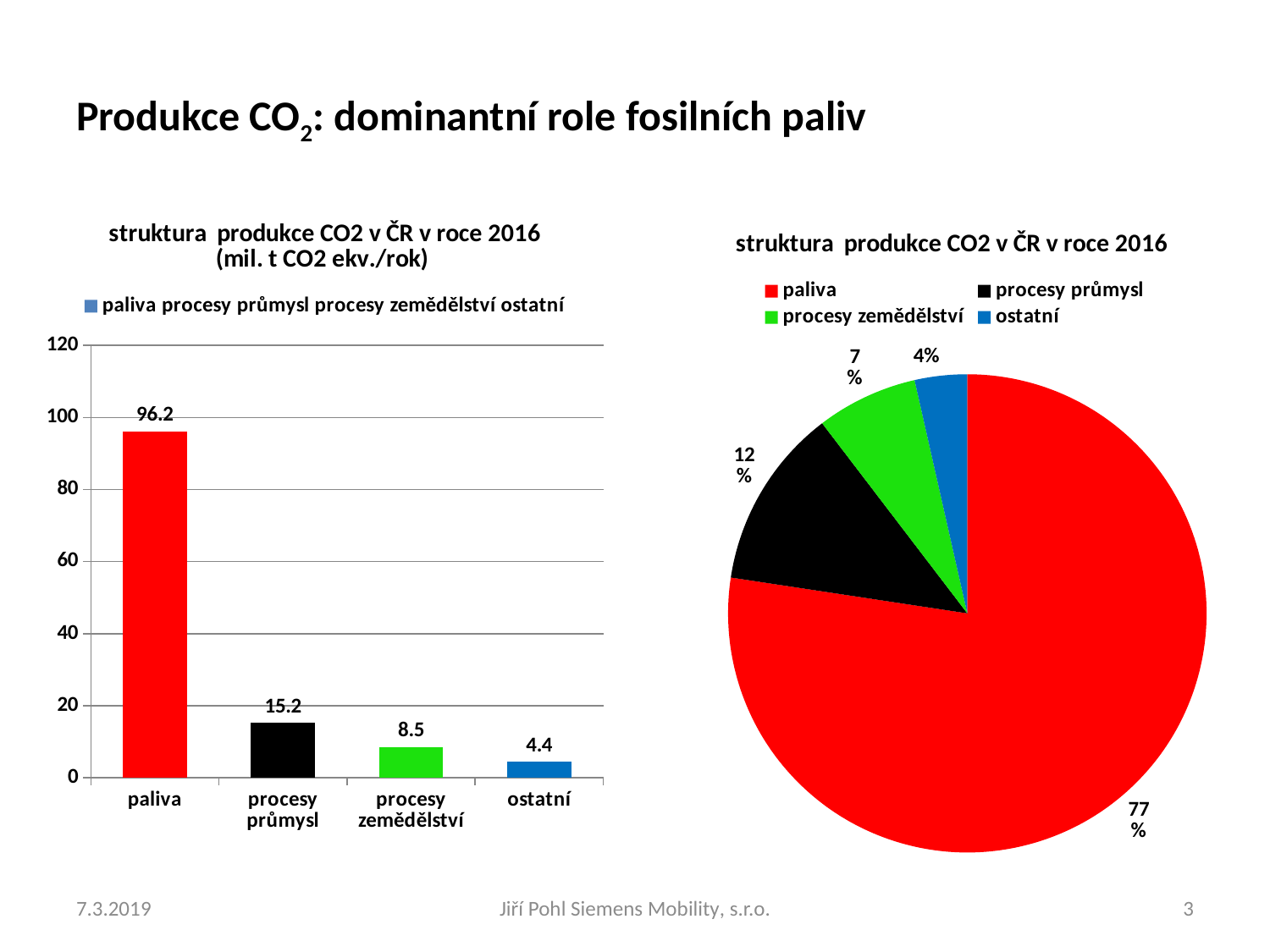
In the bar chart on the left, what is the value for procesy zemědělství? 8.5 In the pie chart on the right, what share does procesy průmysl have? 12% In the bar chart on the left, which is larger: procesy průmysl or procesy zemědělství? procesy průmysl In the pie chart on the right, what share does paliva have? 77% In the bar chart on the left, which category has the highest value? paliva In the bar chart on the left, what is the value for paliva? 96.2 How many entries does the legend of the pie chart on the right list? 4 In the bar chart on the left, what is the value for ostatní? 4.4 What kind of chart is the chart on the left? bar chart In the bar chart on the left, how many categories are shown? 4 In the bar chart on the left, which category has the lowest value? ostatní In the bar chart on the left, what is the difference between the values for paliva and procesy průmysl? 81.0